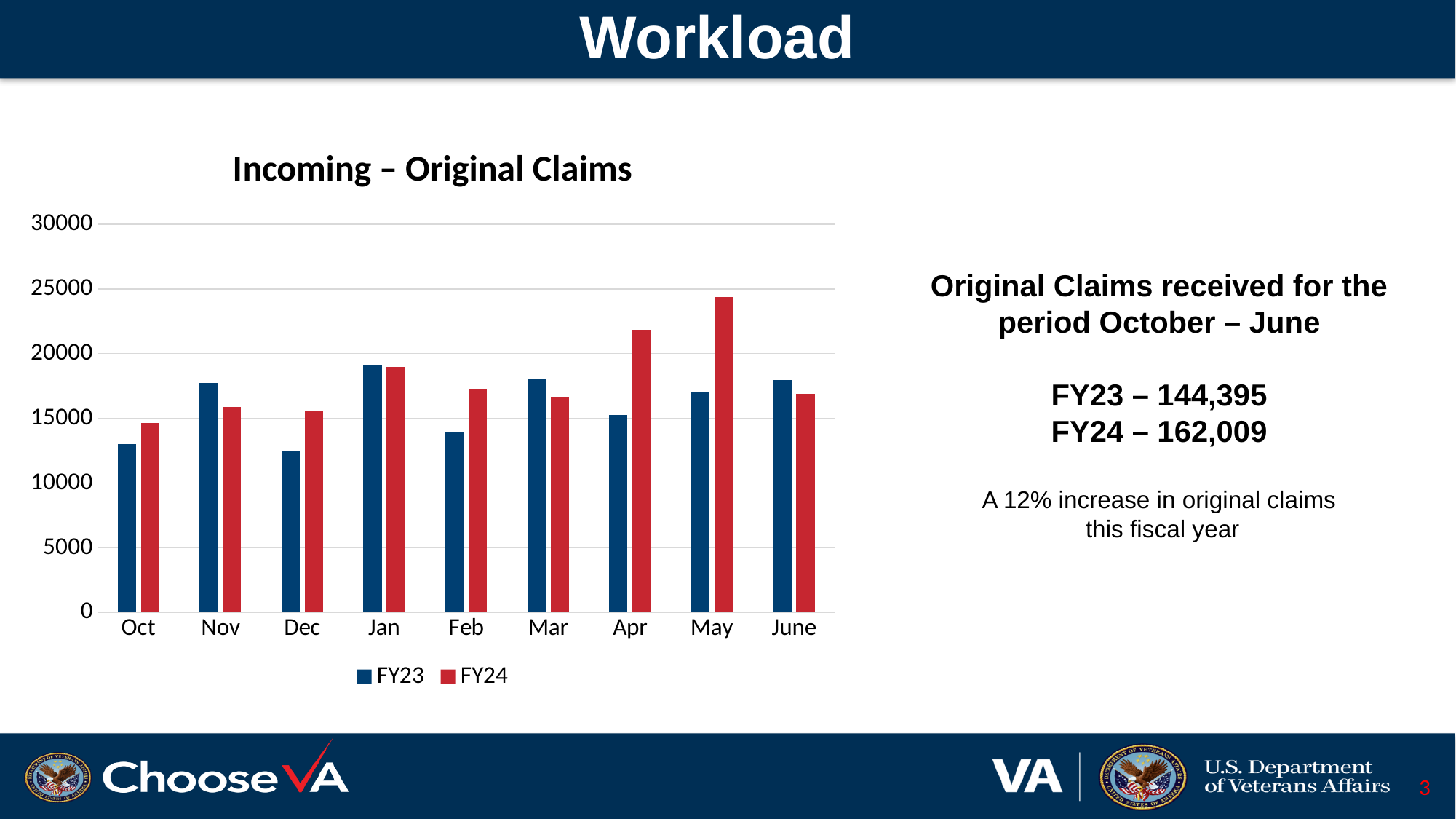
In Nov, which series has the larger value, FY23 or FY24? FY23 How many months are shown on the x axis of the chart? 9 In Apr, which series has the larger value, FY23 or FY24? FY24 In which month is the FY24 value highest? May Is the FY23 value for Dec greater or less than 15000? less What kind of chart is shown on the slide? bar chart Is the FY24 value for Apr greater or less than 20000? greater In which month is the FY23 value lowest? Dec Is the FY24 value for May greater or less than 20000? greater In which month is the FY23 value highest? Jan What is the title of the chart? Incoming – Original Claims How many series does the chart's legend list? 2